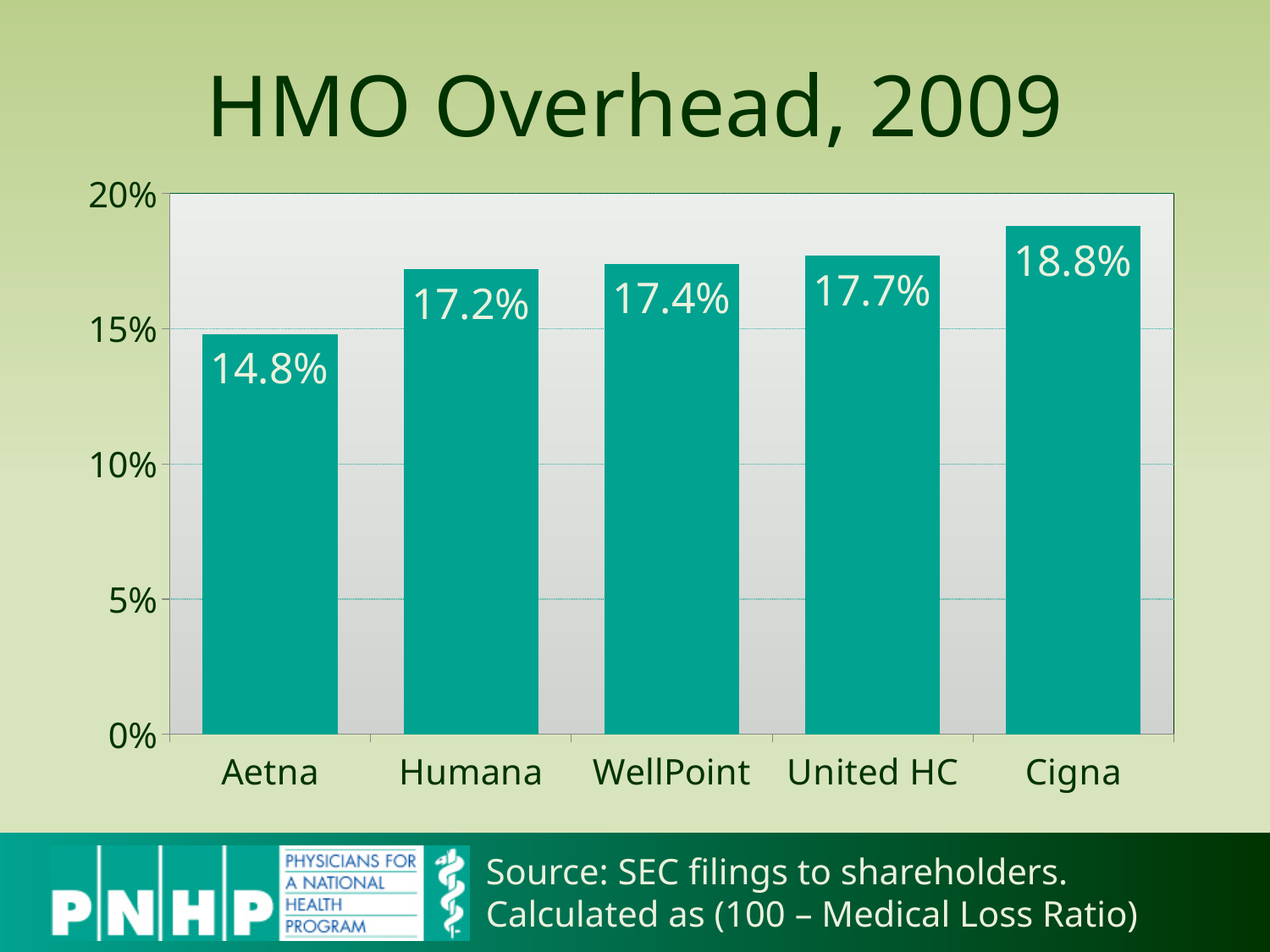
Which HMO has the highest overhead? Cigna What is the difference between Cigna's and Aetna's overhead? 4.0% How many HMOs are shown on the chart? 5 Which HMO has the lowest overhead? Aetna Do the values rise or fall from left to right across the x axis? rise What is the difference between United HC's and Humana's overhead? 0.5% What is the overhead value for WellPoint? 17.4% Is the value for Aetna greater or less than 15%? less Which has a higher overhead, Humana or United HC? United HC What is the overhead value for Cigna? 18.8% What kind of chart is shown on the slide? bar chart What is the overhead value for Aetna? 14.8%